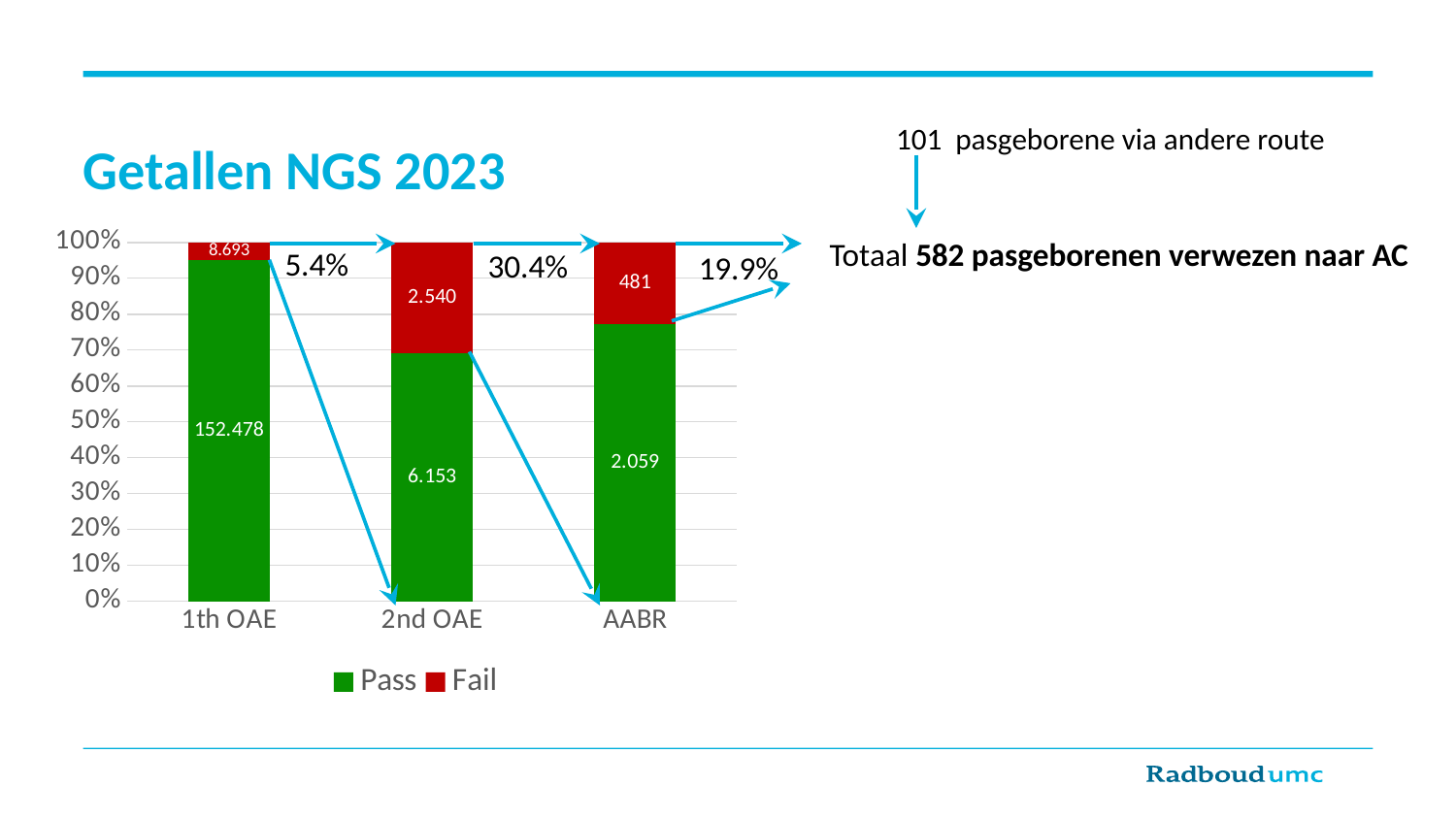
What kind of chart is shown on the slide? Stacked bar chart Which category has the highest Pass value? 1th OAE For AABR, which is larger: the Pass value or the Fail value? Pass How many categories are shown on the x axis? 3 Which category has the lowest Fail value? AABR What is the Fail value for 2nd OAE? 2.540 Is the Pass share of the 1th OAE bar greater or less than 90%? greater What is the difference between the Pass and Fail values for 2nd OAE? 3.613 How many series does the legend list? 2 What is the Fail value for AABR? 481 What is the total of the Pass and Fail values for AABR? 2.540 What is the Pass value for 1th OAE? 152.478